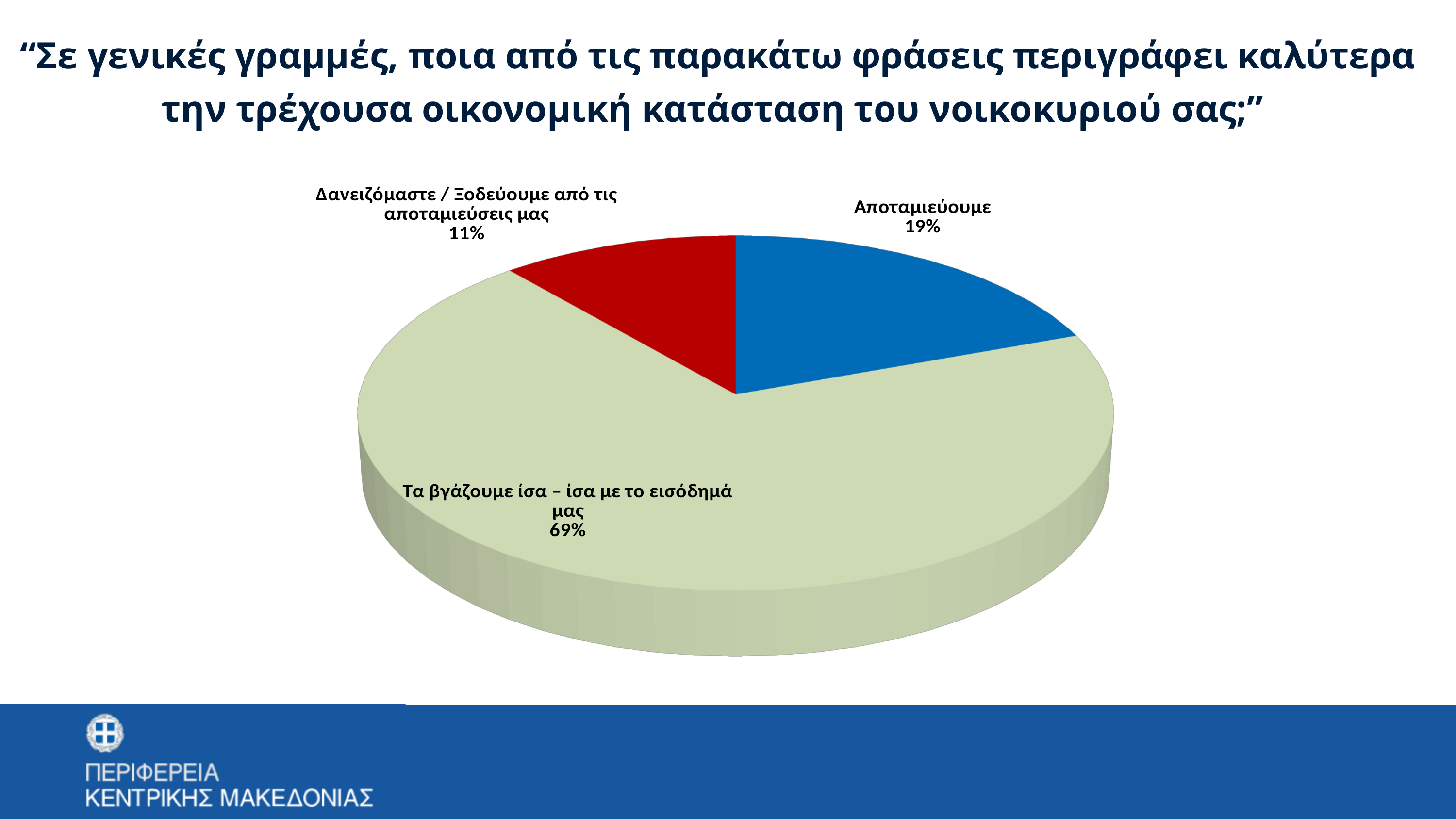
What colour is the slice for "Αποταμιεύουμε"? Blue Which category has the smallest share of the pie? Δανειζόμαστε / Ξοδεύουμε από τις αποταμιεύσεις μας What kind of chart is shown on the slide? Pie chart What is the difference in percentage points between "Τα βγάζουμε ίσα – ίσα με το εισόδημά μας" and "Αποταμιεύουμε"? 50 What is the difference in percentage points between "Αποταμιεύουμε" and "Δανειζόμαστε / Ξοδεύουμε από τις αποταμιεύσεις μας"? 8 Which is larger: the share for "Αποταμιεύουμε" or the share for "Δανειζόμαστε / Ξοδεύουμε από τις αποταμιεύσεις μας"? Αποταμιεύουμε What percentage of the pie is labelled "Αποταμιεύουμε"? 19% Which category has the largest share of the pie? Τα βγάζουμε ίσα – ίσα με το εισόδημά μας How many slices does the pie chart have? 3 What percentage of the pie is labelled "Δανειζόμαστε / Ξοδεύουμε από τις αποταμιεύσεις μας"? 11% What percentage of the pie is labelled "Τα βγάζουμε ίσα – ίσα με το εισόδημά μας"? 69% What colour is the slice for "Δανειζόμαστε / Ξοδεύουμε από τις αποταμιεύσεις μας"? Red